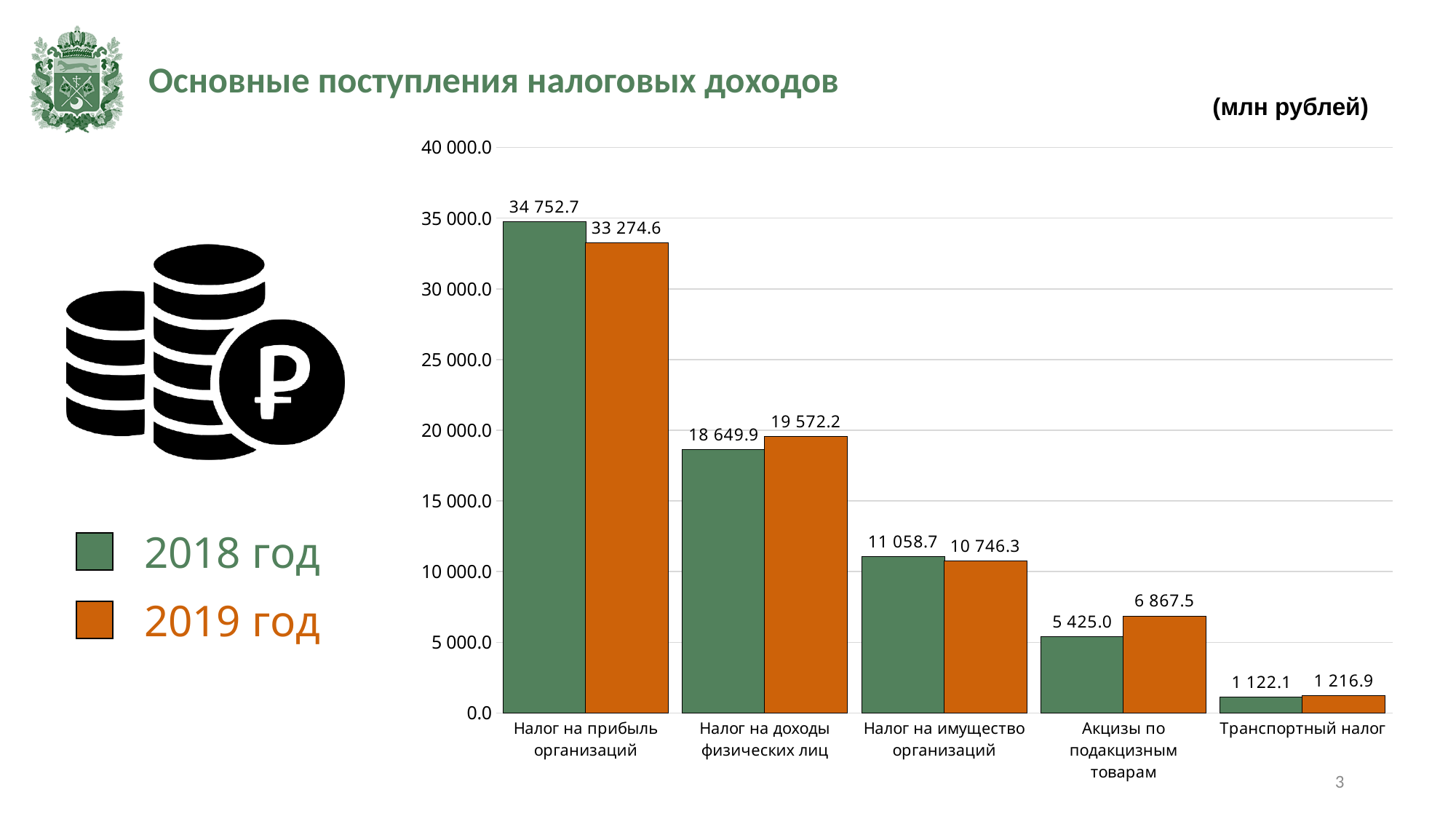
Which is larger for Налог на доходы физических лиц: the 2018 год value or the 2019 год value? 2019 год What is the difference between the 2018 год and 2019 год values for Налог на прибыль организаций? 1 478.1 Is the 2019 год value for Налог на имущество организаций greater or less than 15 000.0? less What is the value for Акцизы по подакцизным товарам in 2019 год? 6 867.5 What type of chart is shown on the slide? bar chart Which category has the highest value in 2019 год? Налог на прибыль организаций What is the value for Налог на прибыль организаций in 2018 год? 34 752.7 How many tax categories are shown on the x axis? 5 What is the value for Транспортный налог in 2018 год? 1 122.1 Which category has the lowest value in 2018 год? Транспортный налог What is the difference between the 2019 год and 2018 год values for Акцизы по подакцизным товарам? 1 442.5 How many series does the legend list? 2